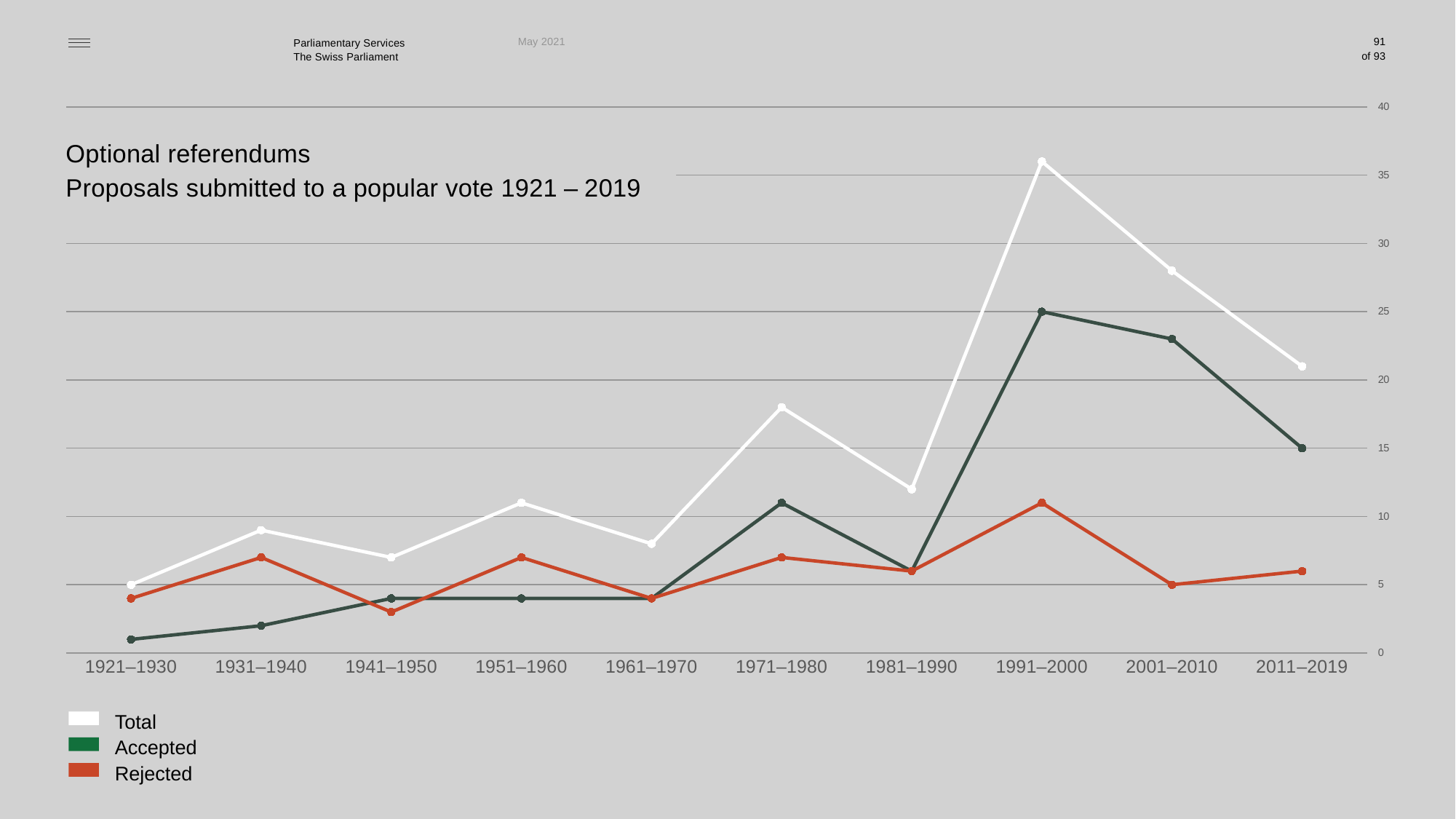
In which period does the Total series reach its highest value? 1991–2000 What kind of chart is shown on the slide? line chart Is the value of the Rejected series for 1991–2000 greater or less than 15? less What is the value of the Accepted series for 1991–2000? 25 How many decade periods are shown on the x axis? 10 Is the value of the Total series for 1991–2000 greater or less than 35? greater In which period is the Accepted series at its lowest? 1921–1930 Does the Total series rise or fall from 1991–2000 to 2011–2019? fall How many series does the legend list? 3 In 1991–2000, which is larger: the Accepted value or the Rejected value? Accepted What is the value of the Total series for 1921–1930? 5 What is the value of the Accepted series for 2011–2019? 15